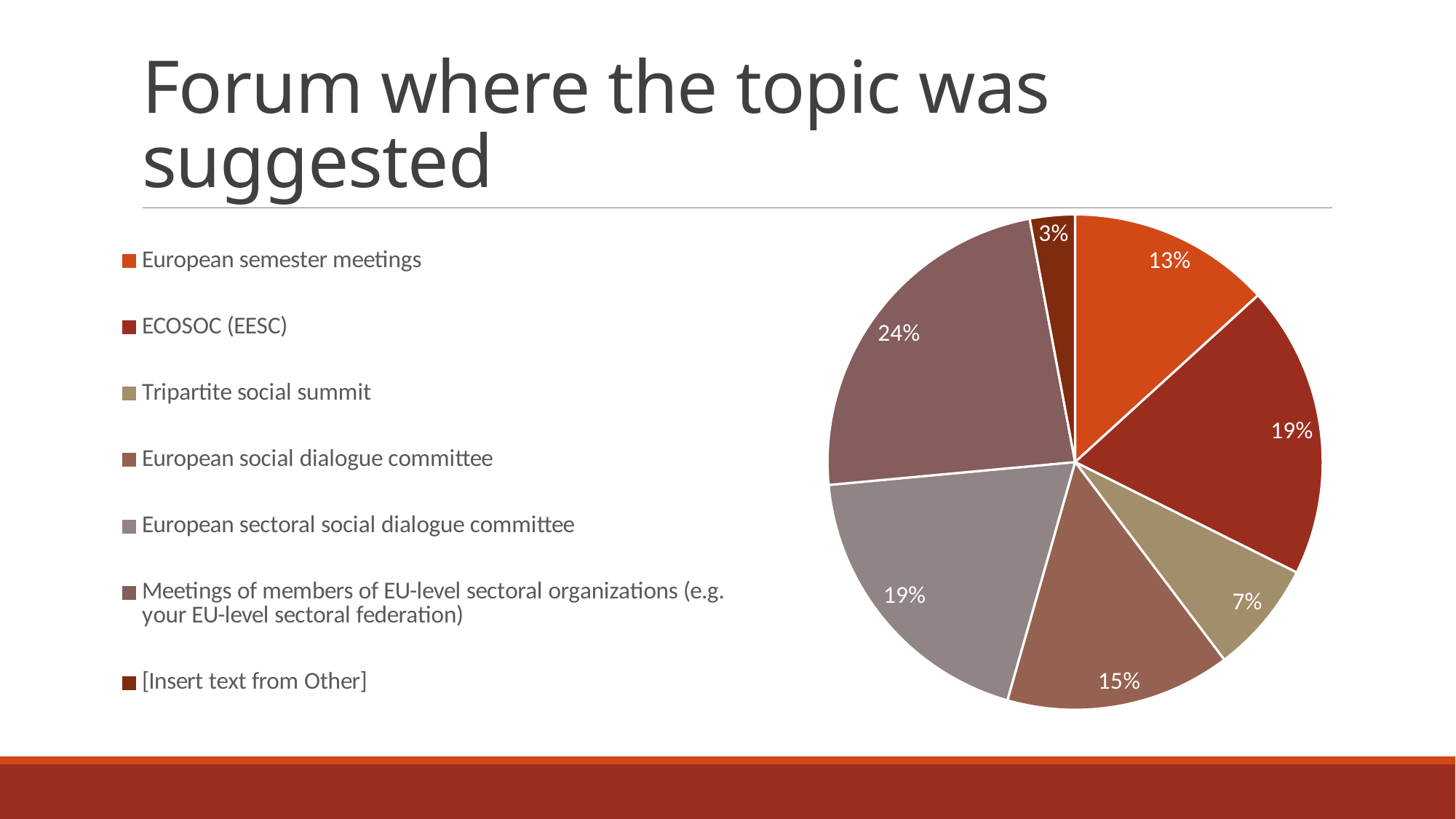
What share of the pie is labelled for European social dialogue committee? 15% Which category has the smallest slice of the pie? [Insert text from Other] What share of the pie is labelled for Meetings of members of EU-level sectoral organizations (e.g. your EU-level sectoral federation)? 24% What share of the pie is labelled for ECOSOC (EESC)? 19% What is the difference in percentage points between the European social dialogue committee slice and the Tripartite social summit slice? 8 What share of the pie is labelled for European semester meetings? 13% Which is larger, the slice for European semester meetings or the slice for European social dialogue committee? European social dialogue committee What share of the pie is labelled for [Insert text from Other]? 3% How many categories does the legend list? 7 What kind of chart is shown on the slide? pie chart Which category has the largest slice of the pie? Meetings of members of EU-level sectoral organizations (e.g. your EU-level sectoral federation) What share of the pie is labelled for Tripartite social summit? 7%